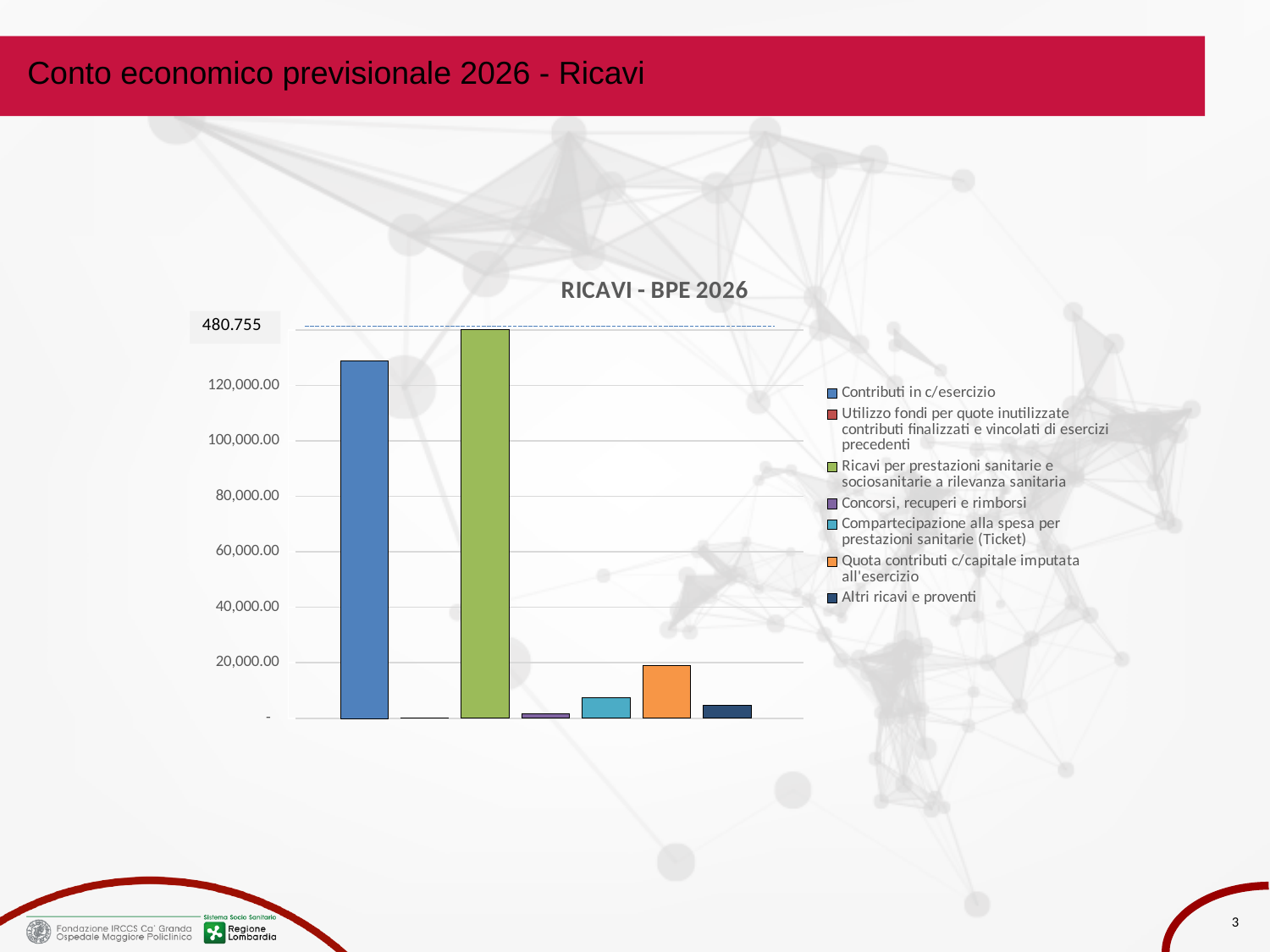
What kind of chart is shown on the slide? bar chart Is the value for Compartecipazione alla spesa per prestazioni sanitarie (Ticket) greater or less than 20,000.00? less How many series does the chart legend list? 7 Which is larger: Contributi in c/esercizio or Ricavi per prestazioni sanitarie e sociosanitarie a rilevanza sanitaria? Ricavi per prestazioni sanitarie e sociosanitarie a rilevanza sanitaria Is the value for Quota contributi c/capitale imputata all'esercizio greater or less than 40,000.00? less Which is larger: Quota contributi c/capitale imputata all'esercizio or Compartecipazione alla spesa per prestazioni sanitarie (Ticket)? Quota contributi c/capitale imputata all'esercizio Is the value for Contributi in c/esercizio greater or less than 100,000.00? greater Which series has the highest value in the chart? Ricavi per prestazioni sanitarie e sociosanitarie a rilevanza sanitaria How many bars are plotted in the chart? 7 Which series has the lowest value in the chart? Utilizzo fondi per quote inutilizzate contributi finalizzati e vincolati di esercizi precedenti What is the title of the chart? RICAVI - BPE 2026